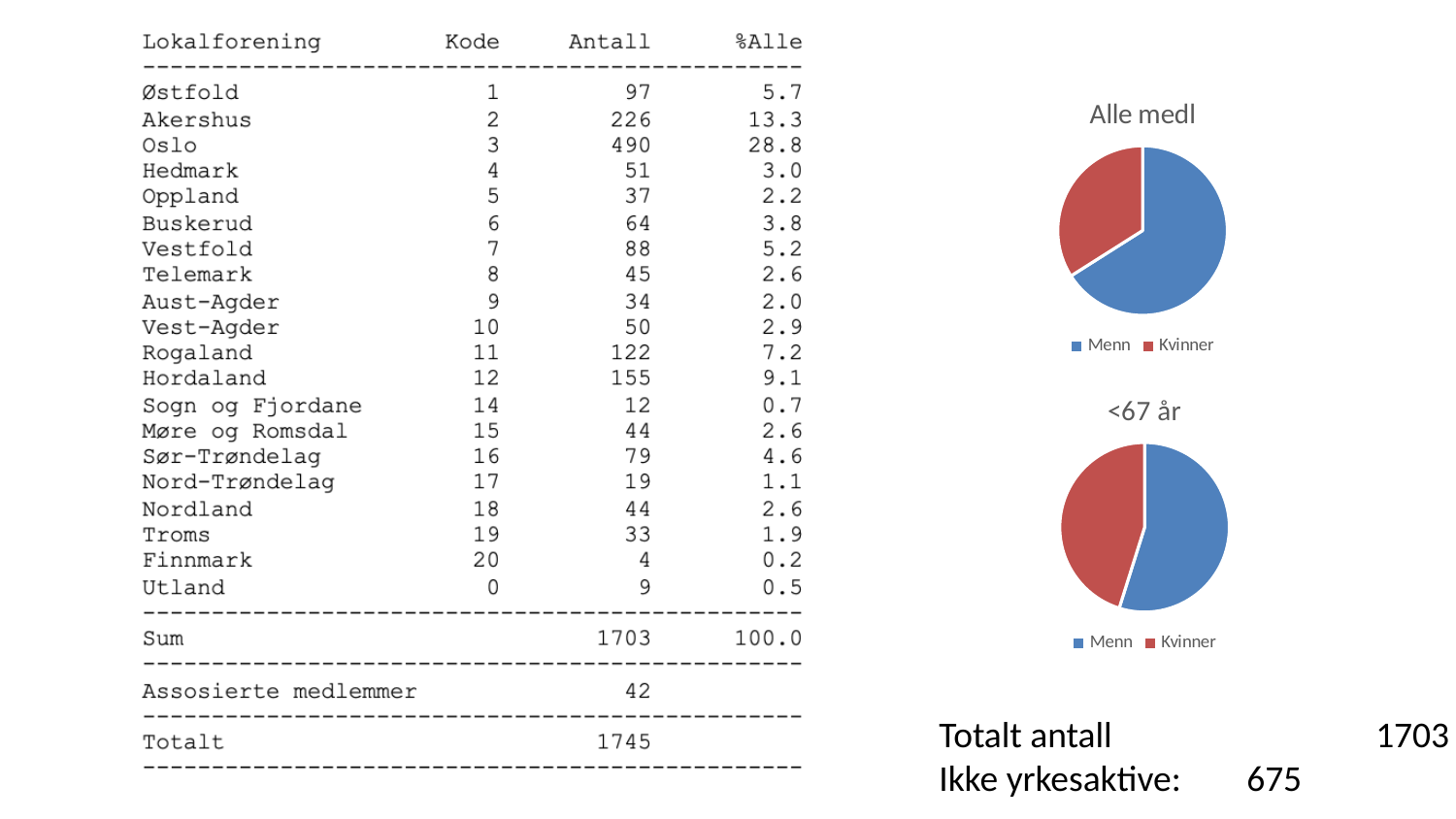
In the "<67 år" chart, which slice is larger, Menn or Kvinner? Menn In the "Alle medl" chart, what colour is the Kvinner slice? red In the "<67 år" chart, which category has the smallest slice? Kvinner What kind of chart is the "Alle medl" chart? pie chart What kind of chart is the "<67 år" chart? pie chart In the "Alle medl" chart, which slice is larger, Menn or Kvinner? Menn In the "Alle medl" chart, how many entries does the legend list? 2 In the "Alle medl" chart, which category has the largest slice? Menn In the "<67 år" chart, how many entries does the legend list? 2 What is the title of the lower pie chart on the slide? <67 år In the "Alle medl" chart, how many slices does the pie have? 2